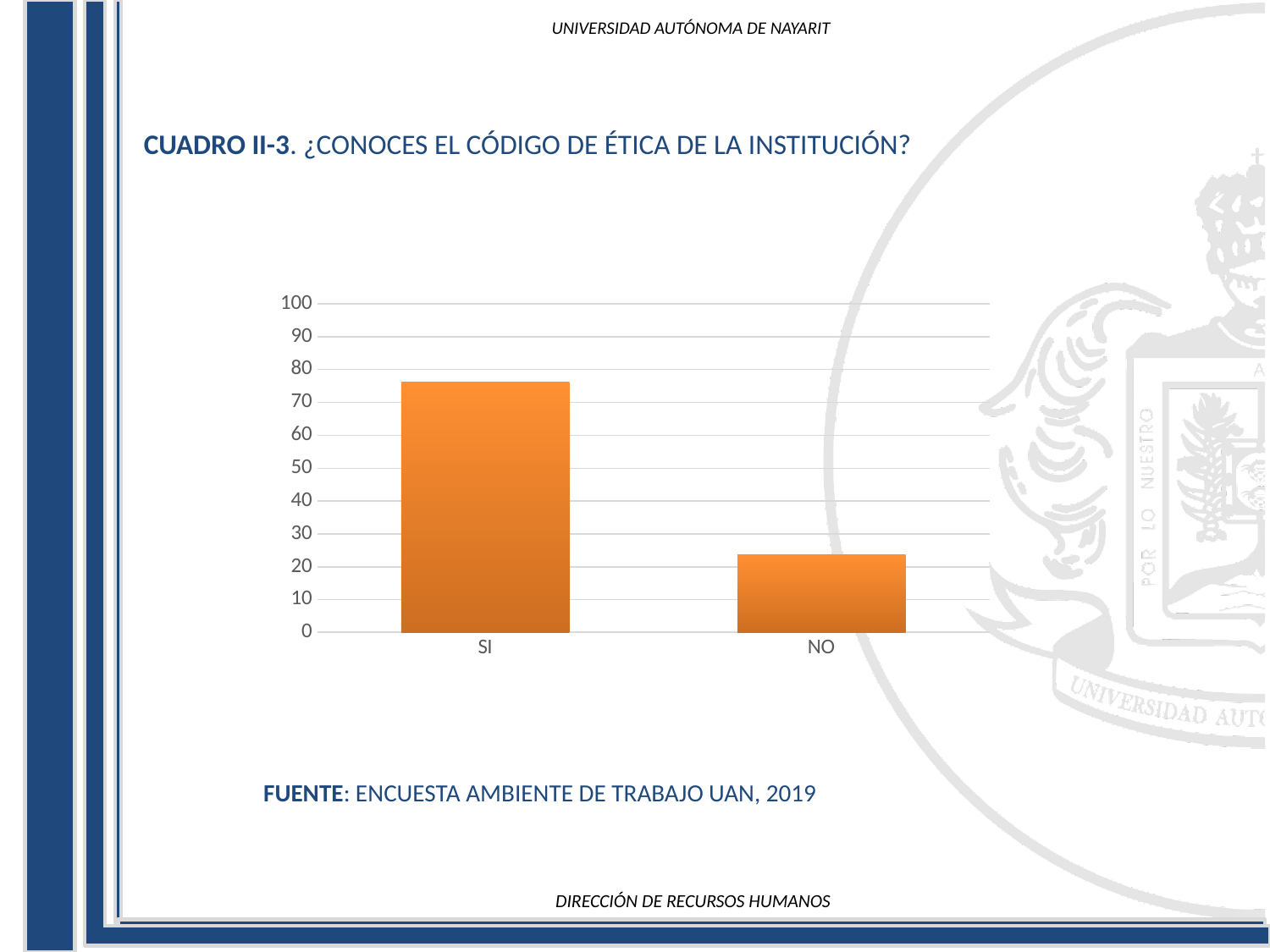
What is the highest value shown on the vertical axis of the chart? 100 Is the value for NO greater or less than 30? less Which category has the lowest bar in the chart? NO Which category has the highest bar in the chart? SI What kind of chart is shown on the slide? bar chart What question does the chart title (CUADRO II-3) ask? ¿CONOCES EL CÓDIGO DE ÉTICA DE LA INSTITUCIÓN? Is the value for SI greater or less than 70? greater Is the value for SI greater or less than 80? less Which bar is taller, SI or NO? SI How many categories are shown on the x axis of the chart? 2